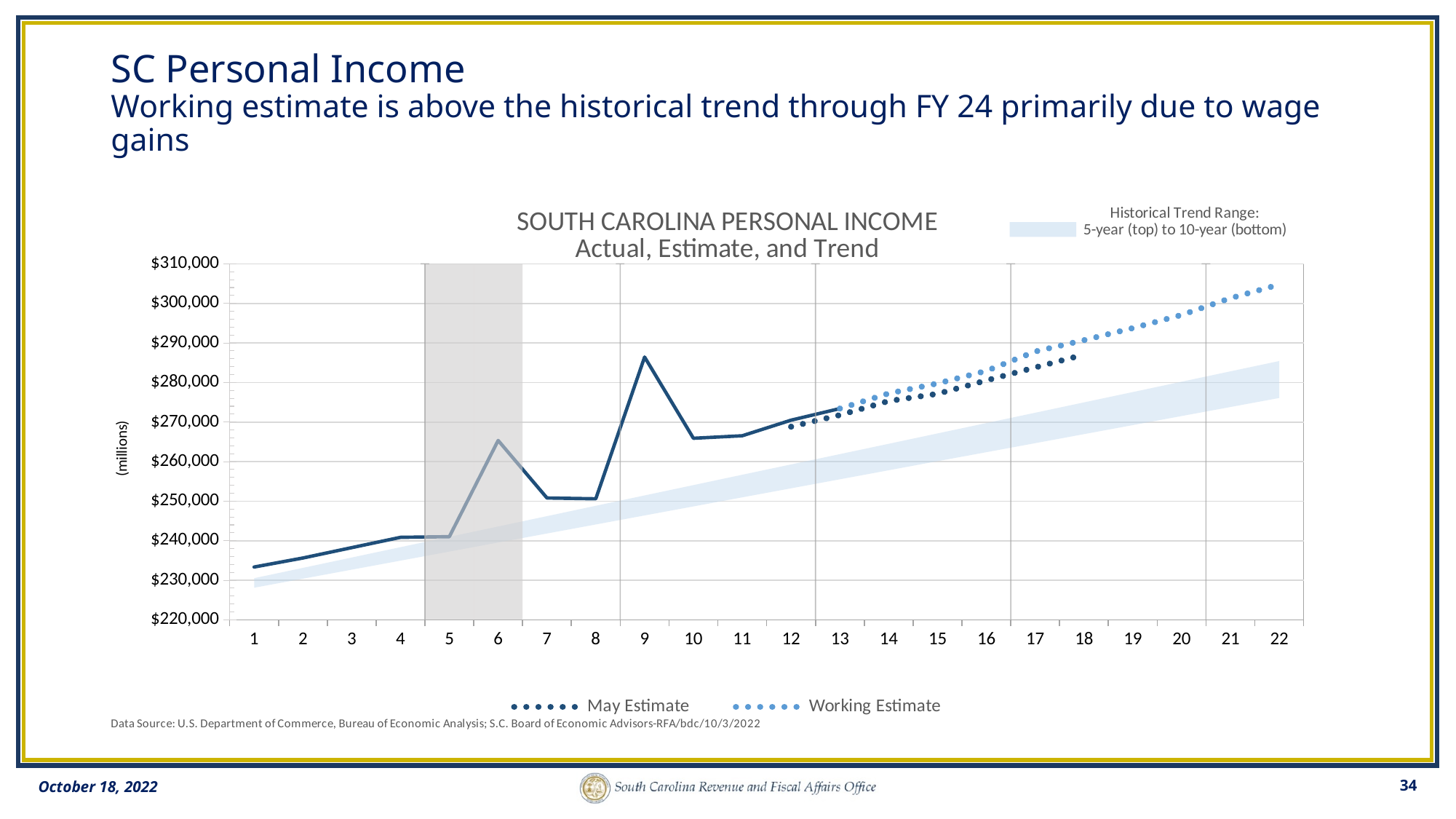
What does the shaded band in the chart represent, according to the legend at the top right? Historical Trend Range: 5-year (top) to 10-year (bottom) How many series does the chart legend list? 2 Which is larger, the solid line value at point 9 or at point 10? Point 9 How many points are labeled along the x axis of the chart? 22 At point 18, which series is higher, the May Estimate or the Working Estimate? Working Estimate Is the value of the solid line at point 1 greater or less than $240,000? less Is the May Estimate value at point 18 greater or less than $290,000? less Among points 1 through 13 on the solid line, which point has the highest value? 9 Do the values of the solid line rise or fall from point 9 to point 10? Fall What kind of chart is shown on the slide? Line chart Is the Working Estimate value at point 22 greater or less than $300,000? greater